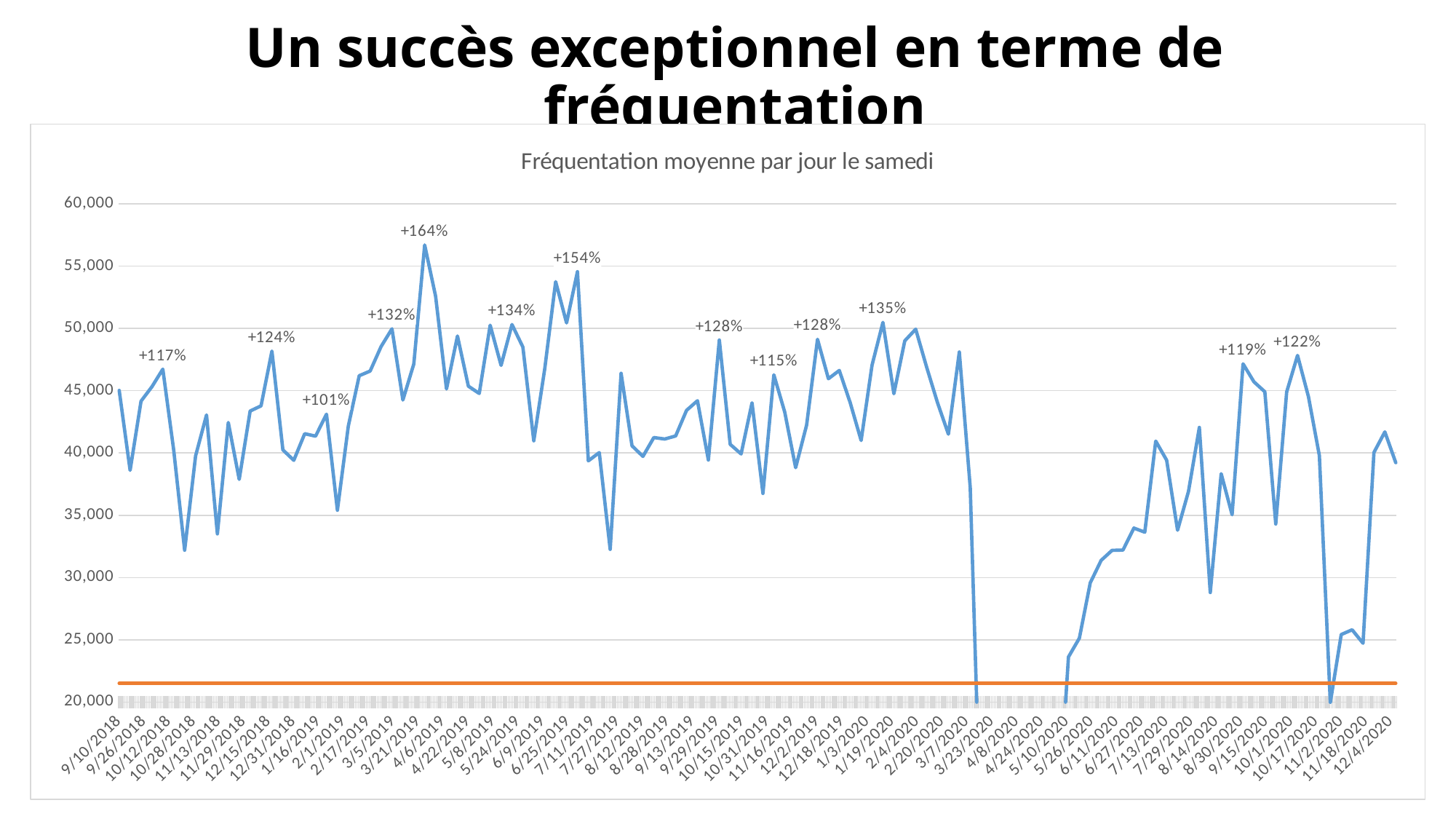
How many percentage data labels are printed on the chart? 13 What kind of chart is shown on the slide? line chart What is the title of the chart? Fréquentation moyenne par jour le samedi Is the value for 3/23/2020 greater or less than 25,000? less What percentage label is shown near the peak around 1/19/2020? +135% Between 3/7/2020 and 3/23/2020, does the value rise or fall? fall What is the highest percentage data label shown on the chart? +164% What is the lowest percentage data label shown on the chart? +101% What percentage label is shown near the peak around 6/25/2019? +154% Which date has the larger value, 4/6/2019 or 3/23/2020? 4/6/2019